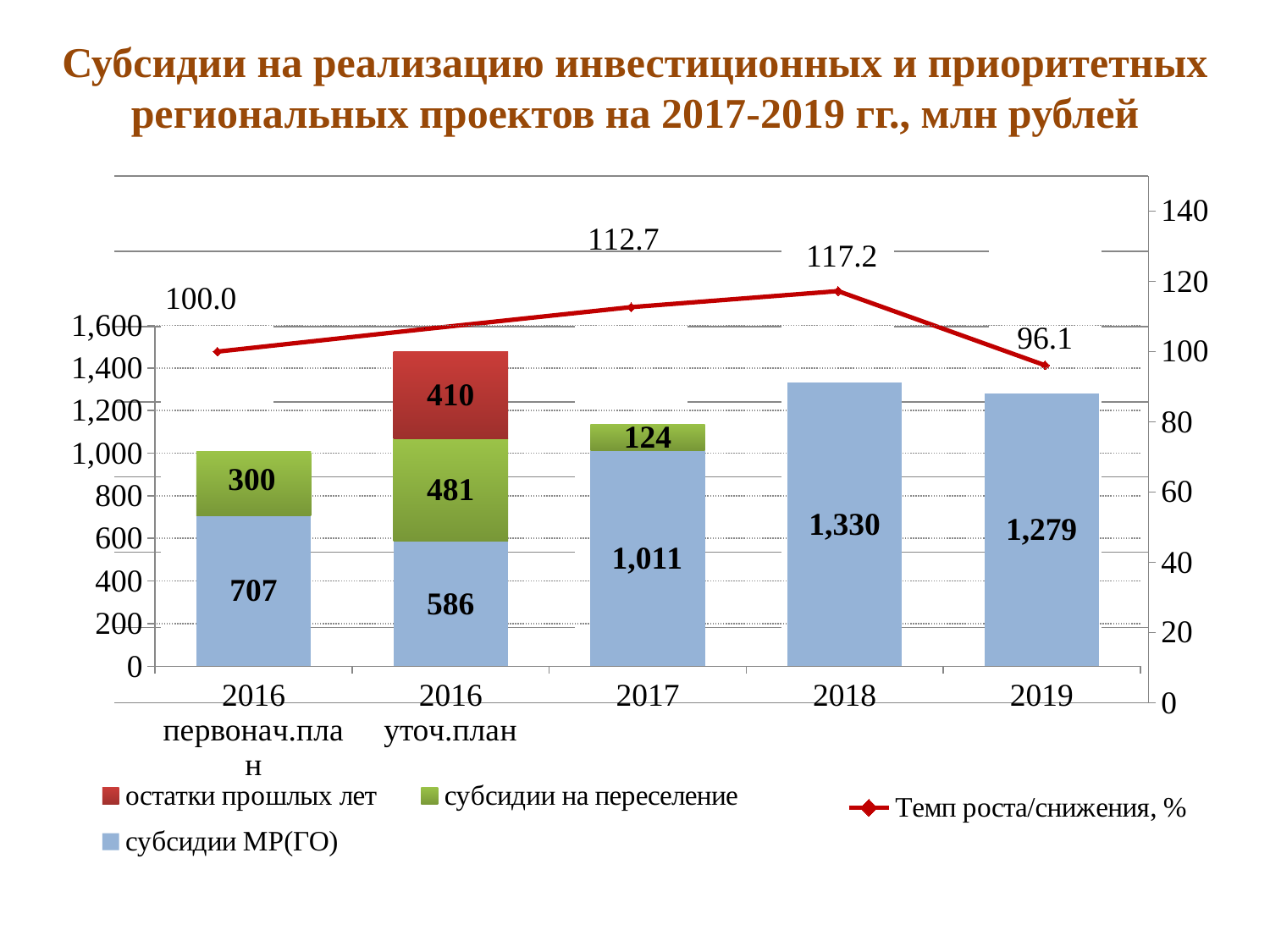
What is the value of субсидии МР(ГО) for 2018? 1,330 What is the value of субсидии на переселение for 2016 уточ.план? 481 How many series does the legend list? 4 What is the value of Темп роста/снижения, % for 2019? 96.1 Which is larger: субсидии на переселение for 2016 первонач.план or for 2017? 2016 первонач.план What is the difference between субсидии МР(ГО) for 2018 and 2019? 51 What is the total of the stacked bar for 2016 первонач.план? 1,007 What is the value of остатки прошлых лет for 2016 уточ.план? 410 Which category has the highest value of субсидии МР(ГО)? 2018 Which category has the lowest value of субсидии МР(ГО)? 2016 уточ.план Which series is shown as a red line? Темп роста/снижения, % What is the total of the stacked bar for 2016 уточ.план? 1,477